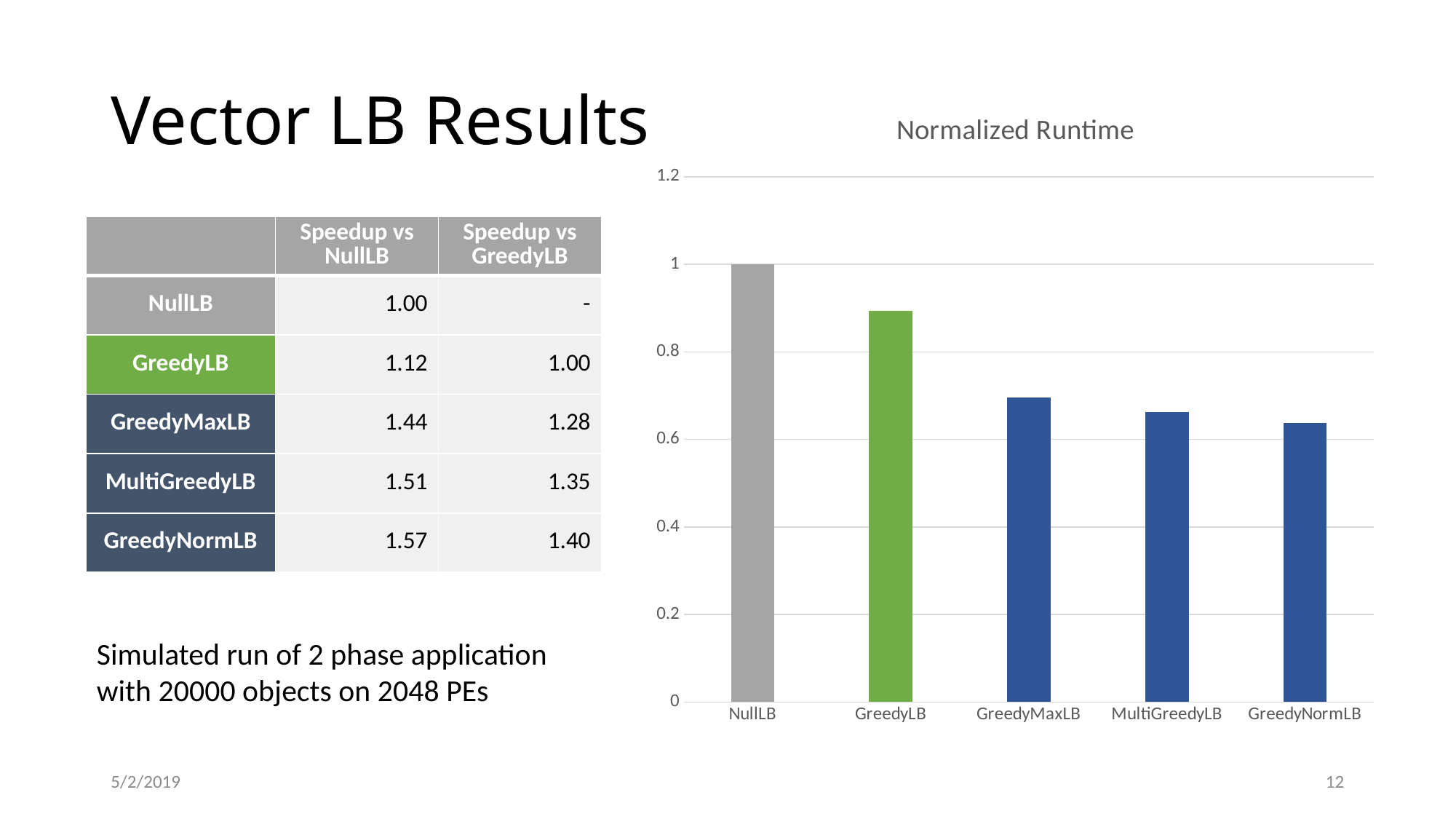
Do the bar values rise or fall from left to right across the x axis? fall Which has the larger normalized runtime, GreedyLB or GreedyMaxLB? GreedyLB Is the value for GreedyLB greater or less than 0.8? greater What is the title of the chart? Normalized Runtime Is the value for MultiGreedyLB greater or less than 0.8? less Which category has the highest normalized runtime in the chart? NullLB What colour is the GreedyLB bar in the chart? green What is the normalized runtime value for NullLB in the chart? 1 How many categories are plotted in the Normalized Runtime chart? 5 What kind of chart is shown on the slide? bar chart Is the value for GreedyNormLB greater or less than 0.6? greater